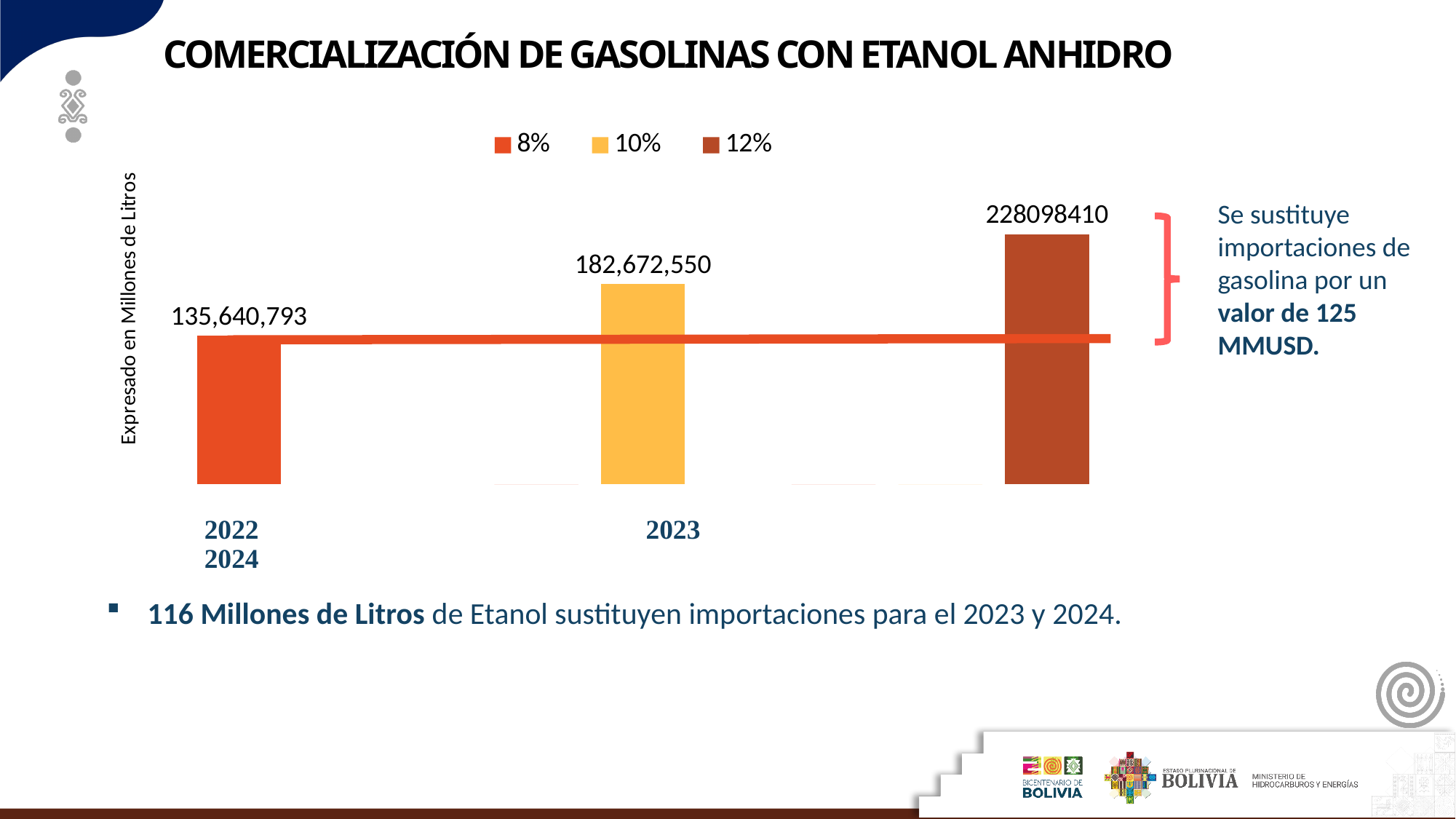
Which series has the lowest value? 8% Which series has the highest value? 12% How many bars are plotted in the chart? 3 What is the value of the 10% bar (2023)? 182,672,550 What is the value of the 12% bar? 228098410 What type of chart is shown on the slide? bar chart Which is larger, the 10% bar or the 12% bar? 12% Do the bar values rise or fall from left to right? rise What is the value of the 8% bar? 135,640,793 What is the difference between the 12% bar and the 10% bar? 45,425,860 How many series does the legend list? 3 What is the difference between the 10% bar and the 8% bar? 47,031,757